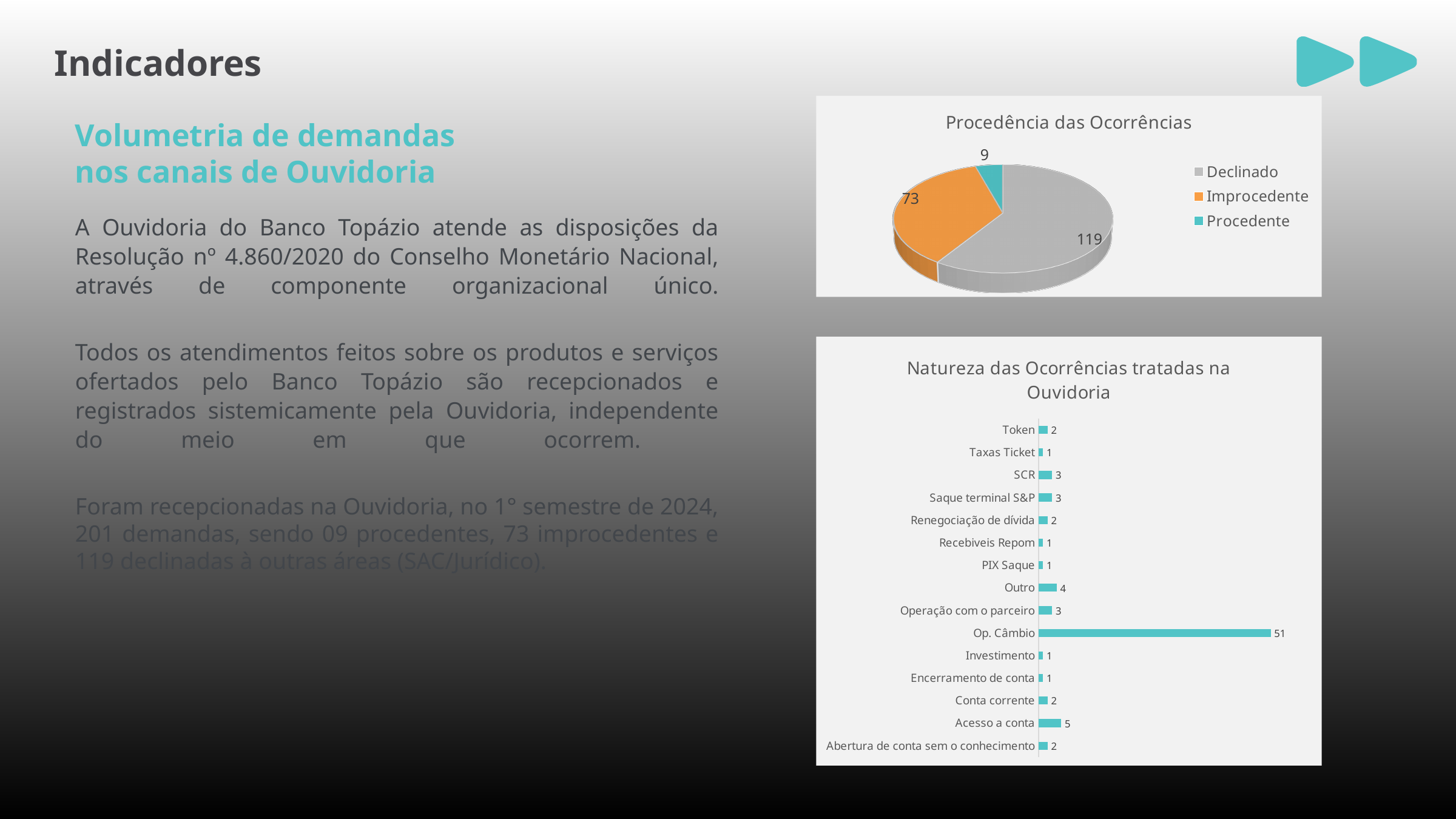
In the 'Procedência das Ocorrências' chart, what is the value for Declinado? 119 In the 'Procedência das Ocorrências' chart, how many entries does the legend list? 3 In the 'Natureza das Ocorrências tratadas na Ouvidoria' chart, which category has the highest value? Op. Câmbio What kind of chart is 'Natureza das Ocorrências tratadas na Ouvidoria'? Bar chart In the 'Natureza das Ocorrências tratadas na Ouvidoria' chart, which is larger, Outro or SCR? Outro In the 'Procedência das Ocorrências' chart, what is the difference between Declinado and Improcedente? 46 In the 'Natureza das Ocorrências tratadas na Ouvidoria' chart, how many categories are shown? 15 In the 'Procedência das Ocorrências' chart, what is the value for Improcedente? 73 In the 'Procedência das Ocorrências' chart, which category has the smallest slice? Procedente In the 'Natureza das Ocorrências tratadas na Ouvidoria' chart, what is the value for Op. Câmbio? 51 In the 'Natureza das Ocorrências tratadas na Ouvidoria' chart, what is the value for Acesso a conta? 5 What kind of chart is 'Procedência das Ocorrências'? Pie chart